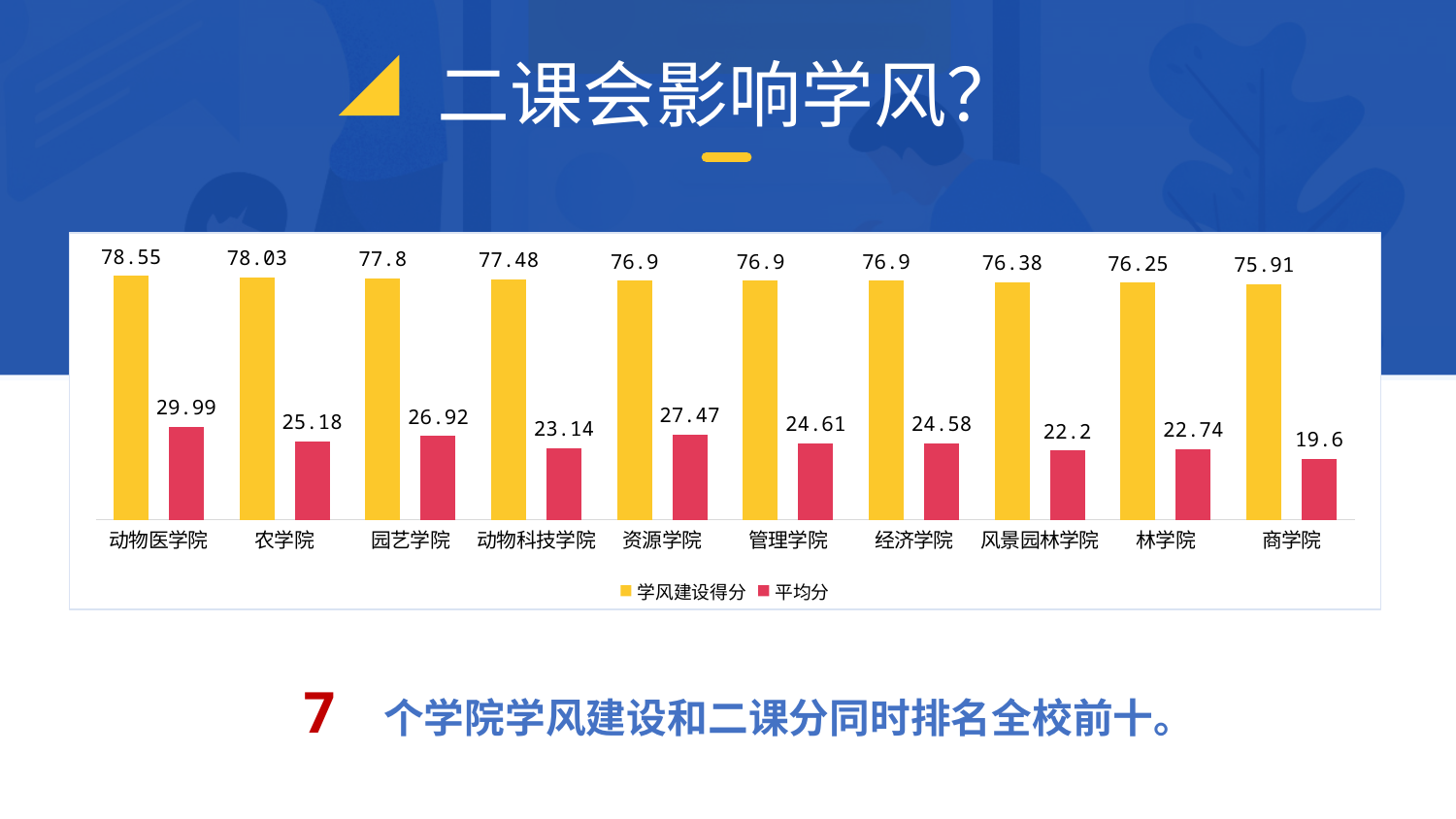
What is the 学风建设得分 value for 动物医学院? 78.55 What is the difference between the 平均分 of 园艺学院 and 农学院? 1.74 What is the 平均分 value for 资源学院? 27.47 How many series does the legend list? 2 Which is larger, the 平均分 for 林学院 or for 风景园林学院? 林学院 What is the difference between the 学风建设得分 and the 平均分 for 动物医学院? 48.56 Which college has the highest 平均分? 动物医学院 Which college has the lowest 平均分? 商学院 Which college has the highest 学风建设得分? 动物医学院 How many colleges are shown on the x axis? 10 What is the 平均分 value for 商学院? 19.6 Do the 学风建设得分 values rise or fall from left to right along the x axis? fall